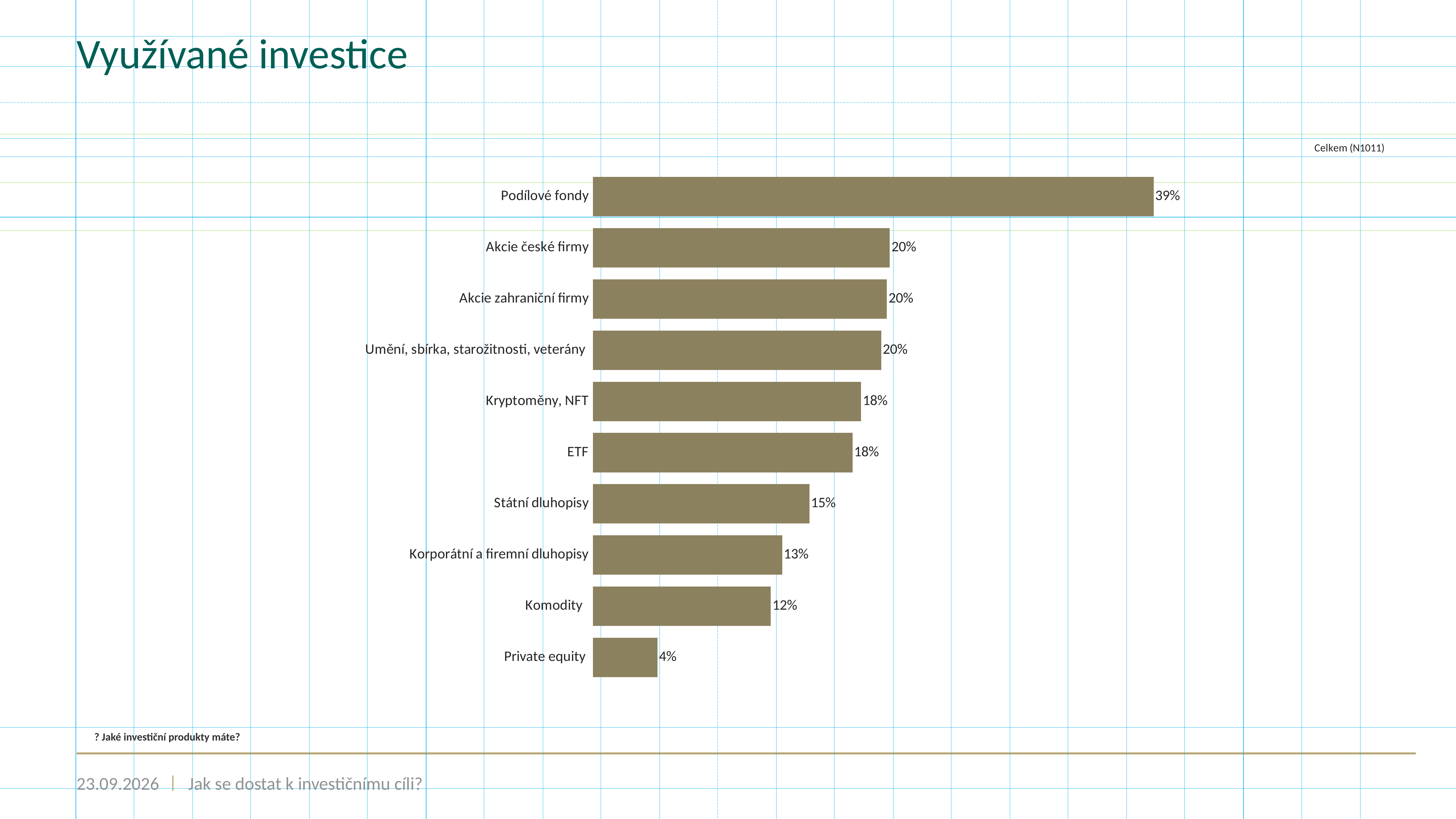
What is the difference between the values for Korporátní a firemní dluhopisy and Private equity? 9% What is the value for Podílové fondy? 39% What is the value for Kryptoměny, NFT? 18% Which category has the highest value? Podílové fondy Which is larger, the value for ETF or the value for Komodity? ETF What is the title of the slide? Využívané investice What is the difference between the values for Podílové fondy and Akcie české firmy? 19% How many categories are shown in the chart? 10 What kind of chart is shown on the slide? Bar chart Which category has the lowest value? Private equity What is the value for Státní dluhopisy? 15% What is the value for Komodity? 12%